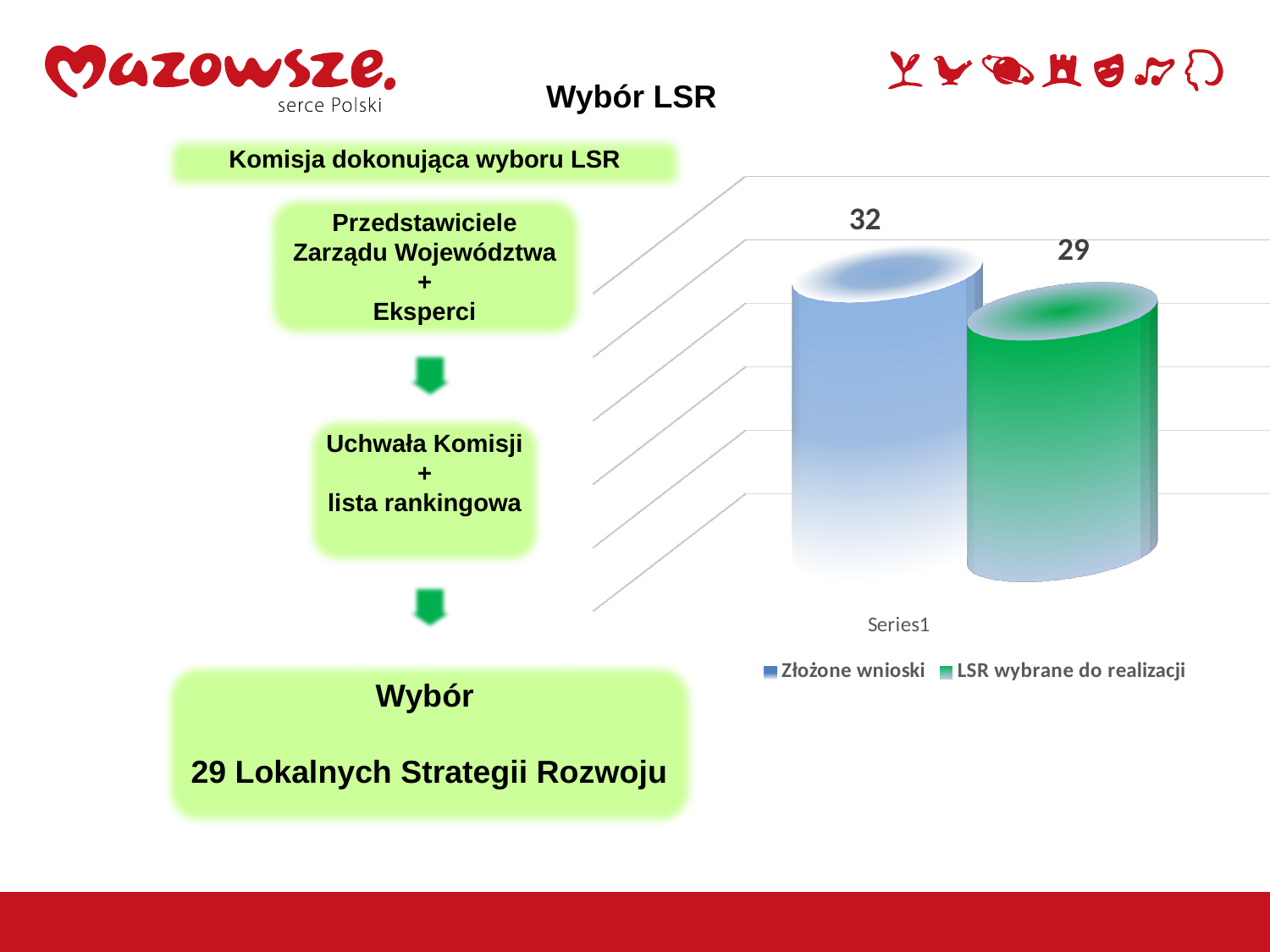
Is the value for "Złożone wnioski" larger or smaller than the value for "LSR wybrane do realizacji"? larger What is the value for "LSR wybrane do realizacji" in the chart? 29 Which series has the higher value in the chart? Złożone wnioski How many bars are plotted in the chart? 2 What kind of chart is shown on the slide? bar chart How many series does the legend list? 2 What is the difference between "Złożone wnioski" and "LSR wybrane do realizacji"? 3 What is the value for "Złożone wnioski" in the chart? 32 Which series has the lower value in the chart? LSR wybrane do realizacji What colour is the bar for "LSR wybrane do realizacji"? green What is the category label shown on the x axis of the chart? Series1